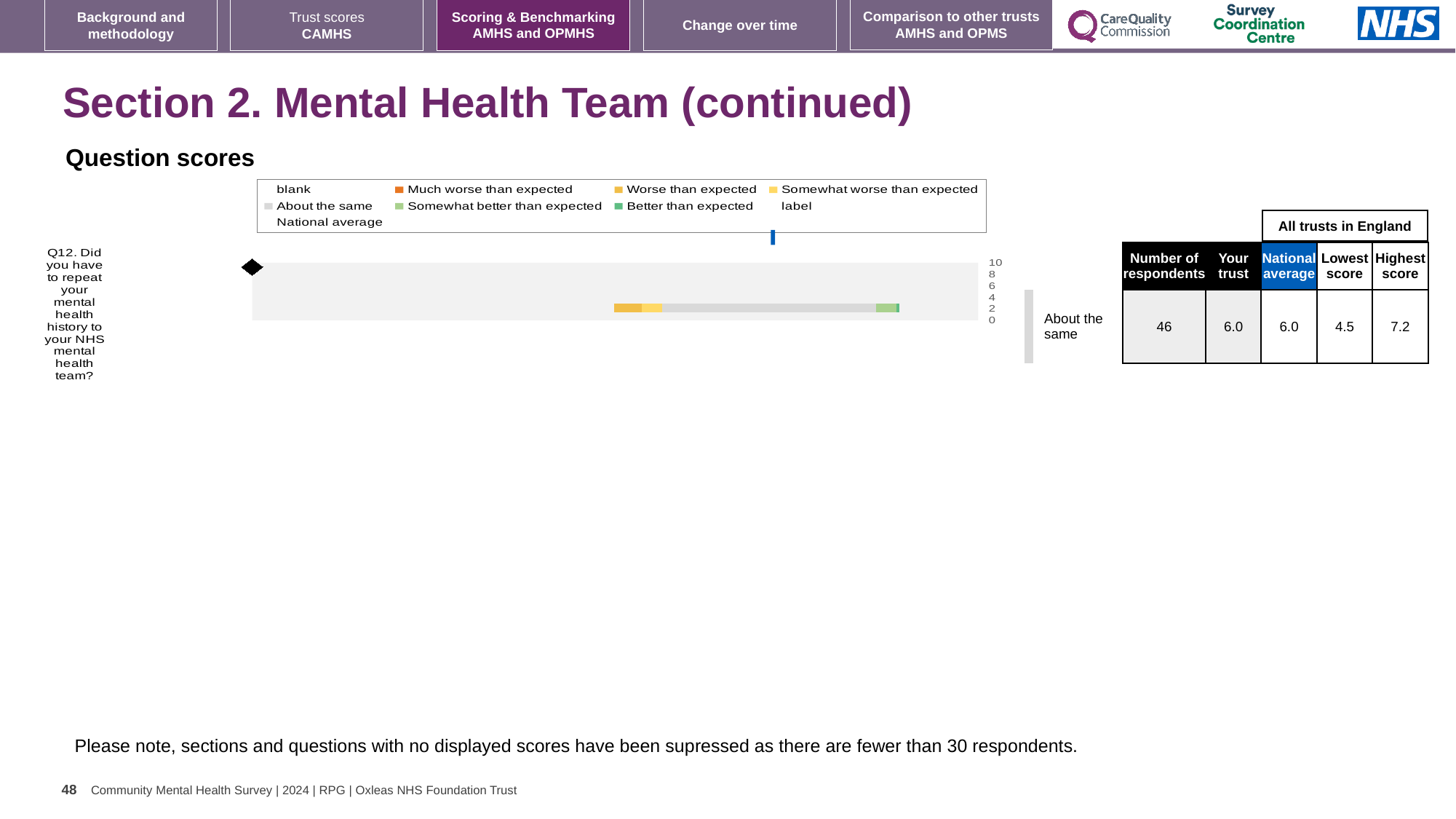
What is the difference between the highest and lowest scores for Q12 across all trusts in England? 2.7 What is the 'Your trust' score for Q12 shown beside the chart? 6.0 What is the national average score for Q12 shown beside the chart? 6.0 Which benchmark category is the trust's Q12 score placed in? About the same What is the highest tick value shown on the chart's axis? 10 Which question is plotted in the question scores chart? Q12. Did you have to repeat your mental health history to your NHS mental health team? What kind of chart is used to show the question scores? bar chart What is the highest score among all trusts in England for Q12? 7.2 How many questions (categories) are plotted in the question scores chart? 1 Is the 'Your trust' score for Q12 larger or smaller than the highest score across all trusts in England? smaller What is the lowest score among all trusts in England for Q12? 4.5 How many respondents answered Q12? 46